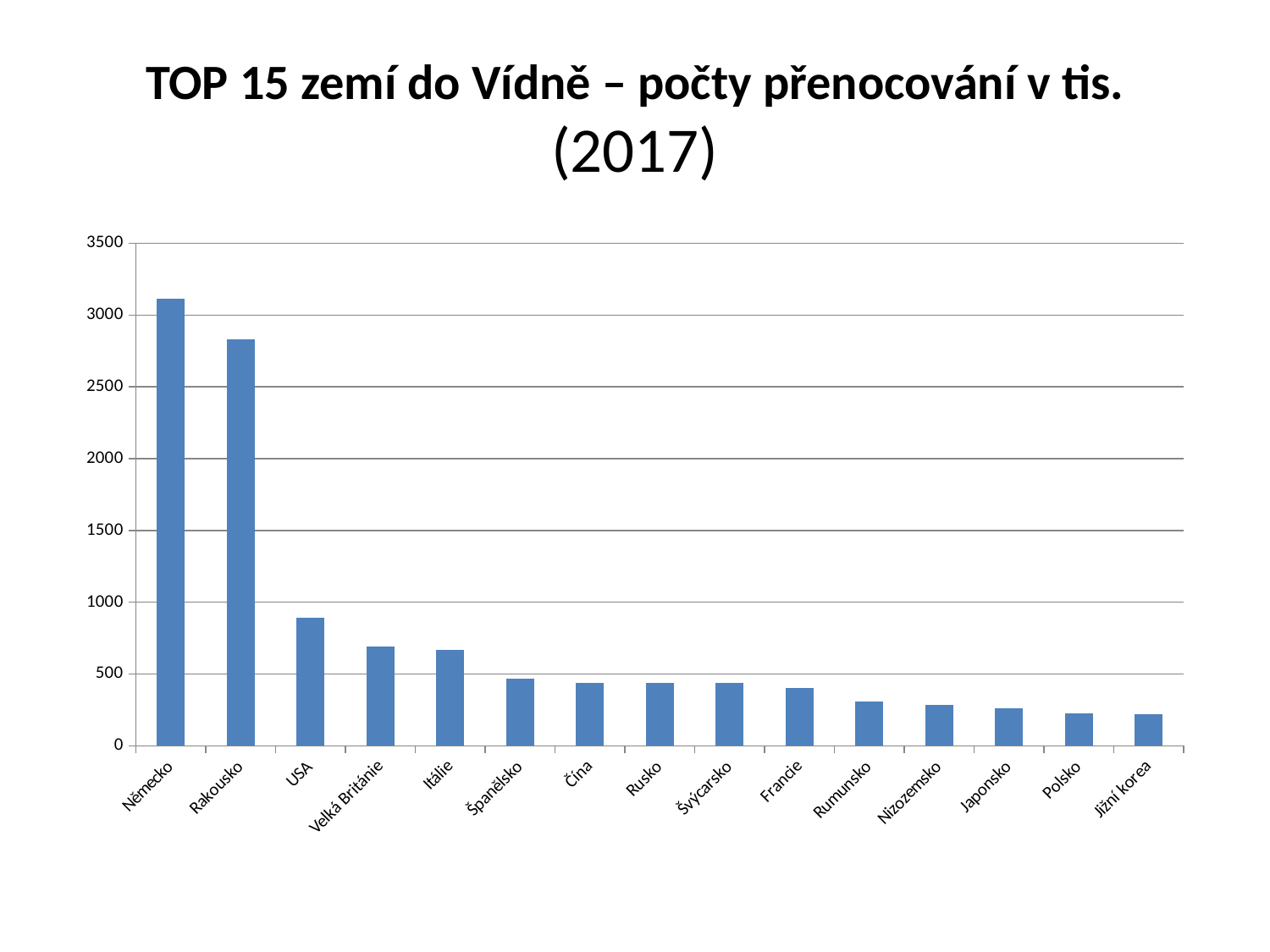
Is the value for Rakousko greater or less than 3000? less Is the value for Rumunsko greater or less than 500? less Is the value for Velká Británie greater or less than 500? greater Which has a larger value, Německo or Rakousko? Německo Which year does the chart title say the data is for? 2017 Which country has the highest number of overnight stays in the chart? Německo Which has a larger value, USA or Velká Británie? USA What kind of chart is shown on the slide? bar chart How many countries are shown on the x axis of the chart? 15 Do the values rise or fall from left to right along the x axis? fall